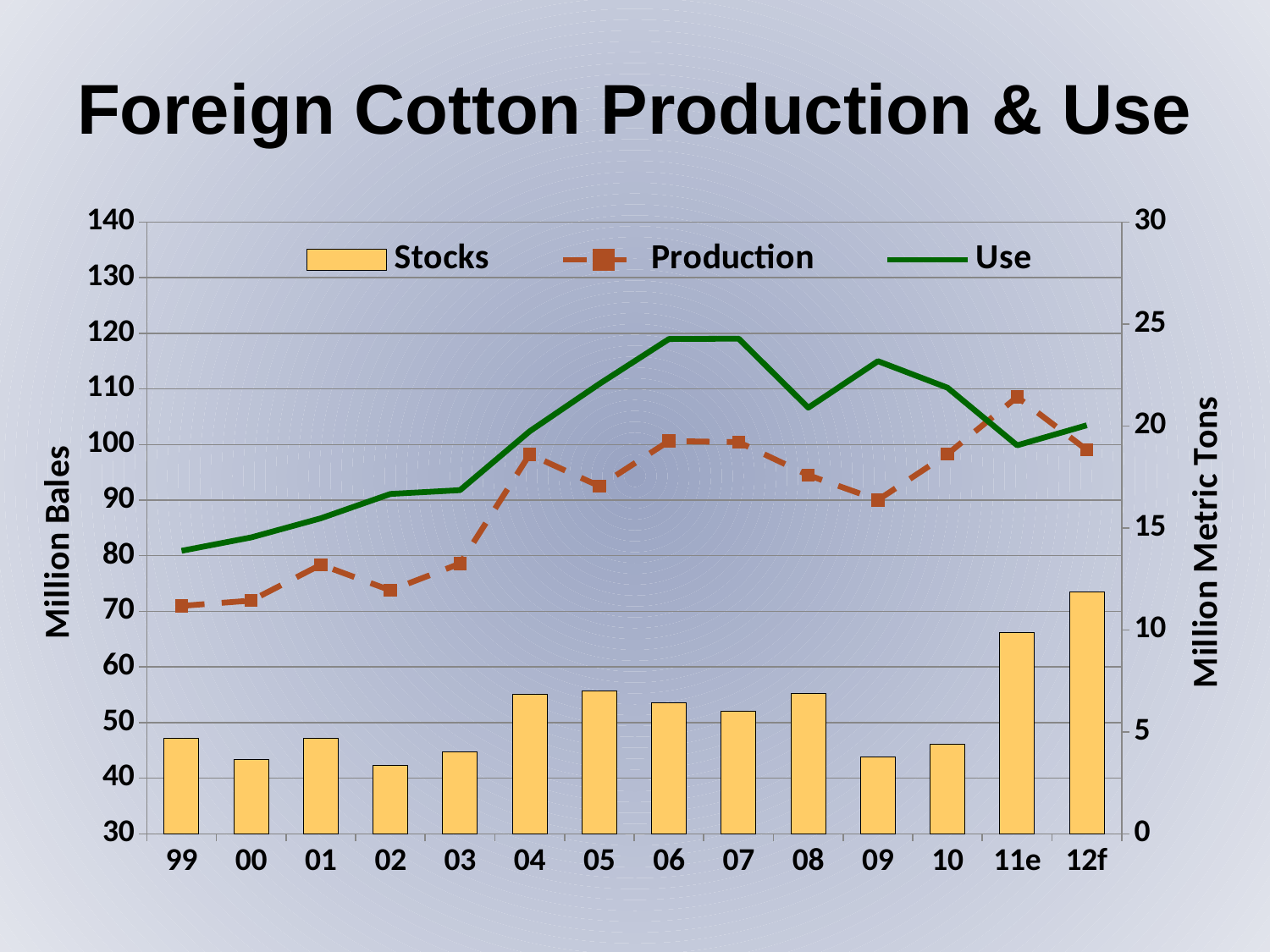
What kind of chart is shown on the slide? A combination bar and line chart In which year is the Production line at its highest point? 11e Is the Use value for 06 greater or less than 110 million bales? greater In which year is the Use line at its lowest point? 99 Is the Stocks value for 12f greater or less than 70 million bales? greater Which year has the highest Stocks bar? 12f How many series does the legend list? 3 Is the Production value for 99 greater or less than 80 million bales? less Does the Use line rise or fall from 99 to 06? Rise Which year has the larger Stocks bar, 04 or 09? 04 Which year has the lowest Stocks bar? 02 How many years are shown along the x axis? 14